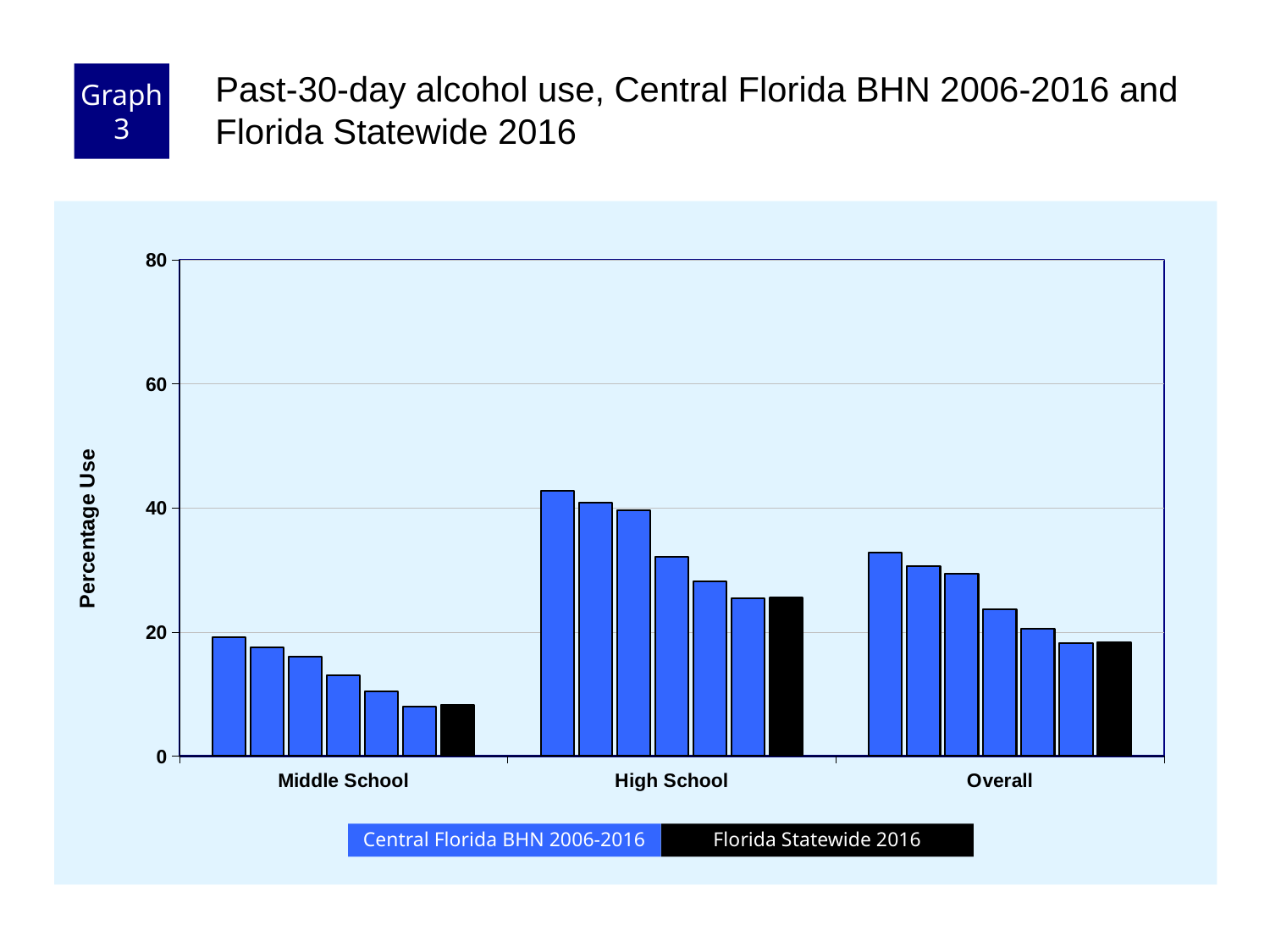
Is the Florida Statewide 2016 value for High School greater or less than 20? greater Which is larger, the Florida Statewide 2016 value for High School or for Middle School? High School What kind of chart is shown on the slide? bar chart Within each category, do the Central Florida BHN 2006-2016 bars rise or fall from left to right? fall How many categories are shown on the x axis? 3 Is the tallest Central Florida BHN bar for High School greater or less than 40? greater Is the tallest Central Florida BHN bar for Overall greater or less than 20? greater Which category has the lowest bars overall? Middle School How many series does the legend list? 2 What is the label on the y axis? Percentage Use Which category has the highest bars overall? High School